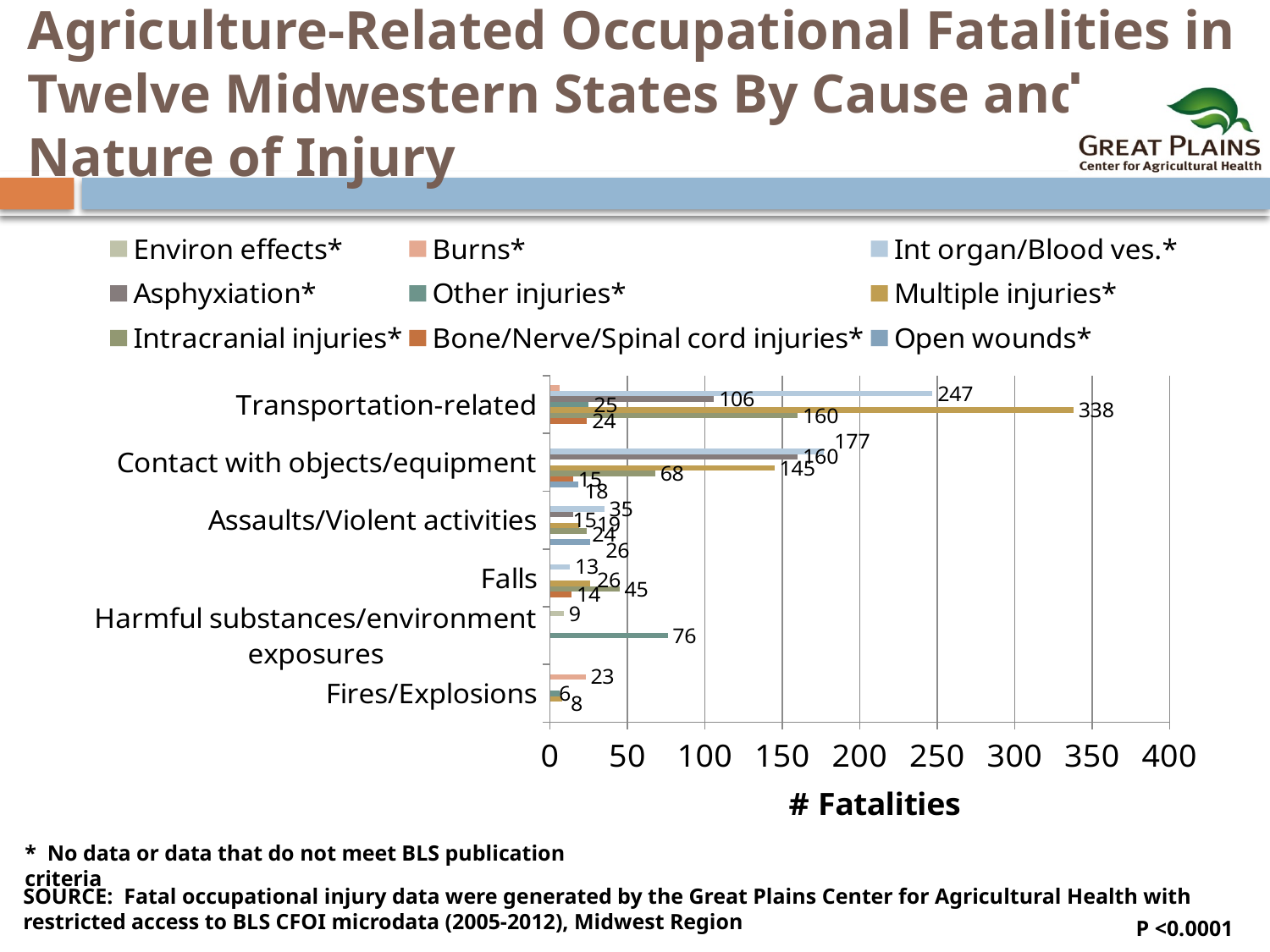
What is the difference between the Multiple injuries value and the Int organ/Blood ves. value for Transportation-related? 91 What type of chart is shown on the slide? Bar chart How many series does the legend list? 9 What is the title of the horizontal axis? # Fatalities What is the number of fatalities for Other injuries in the Harmful substances/environment exposures category? 76 What is the number of fatalities for Multiple injuries in the Transportation-related category? 338 Which is larger: Int organ/Blood ves. for Transportation-related or Int organ/Blood ves. for Contact with objects/equipment? Transportation-related What is the number of fatalities for Int organ/Blood ves. in the Transportation-related category? 247 How many cause categories are shown on the vertical axis? 6 What is the number of fatalities for Burns in the Fires/Explosions category? 23 Which cause category has the single highest bar in the chart? Transportation-related What is the number of fatalities for Asphyxiation in the Transportation-related category? 106